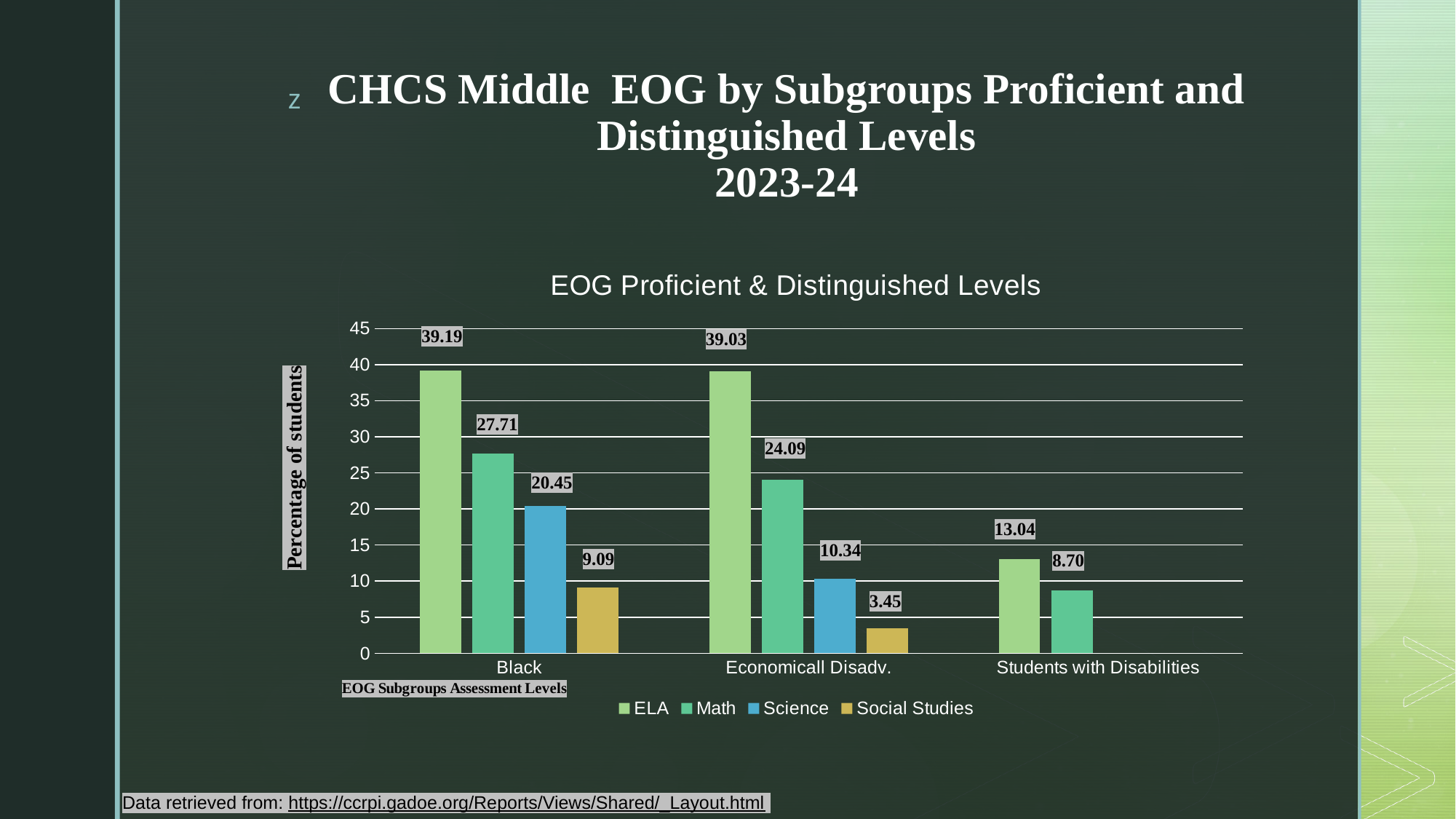
Is the Math value for Economicall Disadv. greater or less than 25? less What is the Social Studies value for the Economicall Disadv. subgroup? 3.45 Which subject has the lowest value for the Black subgroup? Social Studies Which subgroup has the lowest ELA value? Students with Disabilities Which is larger: the Science value for Black or the Science value for Economicall Disadv.? Black What is the ELA value for the Black subgroup? 39.19 What type of chart is shown? Bar chart What is the difference between the Math values for Black and Economicall Disadv.? 3.62 What is the Math value for Students with Disabilities? 8.70 What is the Science value for the Black subgroup? 20.45 How many subgroups are shown on the x axis? 3 How many series does the legend list? 4